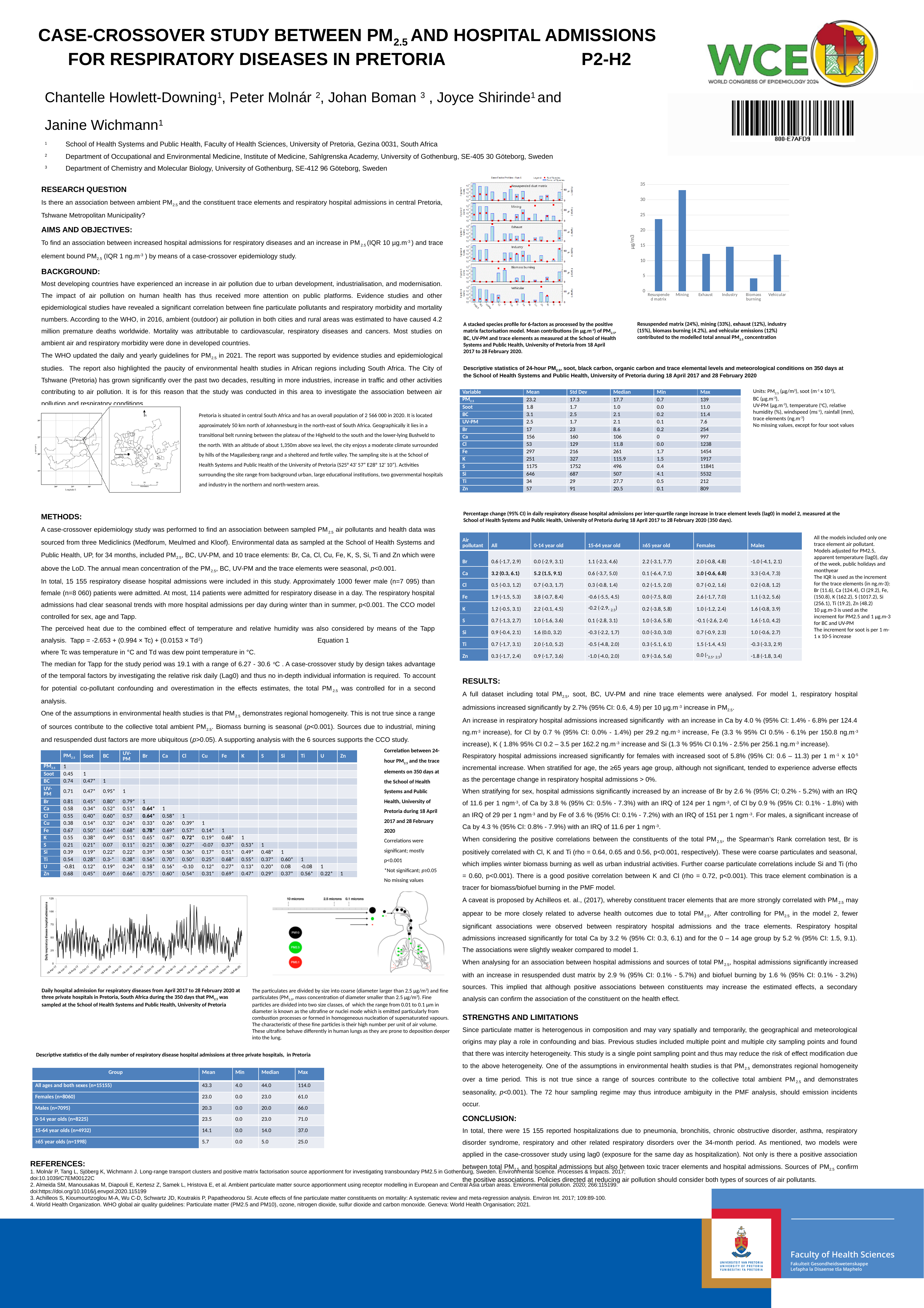
In the bar chart of source contributions (µg/m3) at the top right, is the value for Resuspended matrix greater or less than 20? greater In the bar chart of source contributions (µg/m3) at the top right, which source has the highest bar? Mining What kind of chart is the chart at the top right showing source contributions in µg/m3? bar chart In the bar chart of source contributions (µg/m3) at the top right, is the value for Exhaust greater or less than 15? less What kind of chart is the chart at the bottom left showing daily respiratory disease hospital admissions over time? line chart In the bar chart of source contributions (µg/m3) at the top right, is the value for Mining greater or less than 30? greater In the bar chart of source contributions (µg/m3) at the top right, which is larger, the bar for Industry or the bar for Biomass burning? Industry What is the y-axis label of the bar chart of source contributions at the top right? µg/m3 In the bar chart of source contributions (µg/m3) at the top right, which is larger, the bar for Mining or the bar for Resuspended matrix? Mining In the bar chart of source contributions (µg/m3) at the top right, how many source categories are shown on the x axis? 6 In the bar chart of source contributions (µg/m3) at the top right, which source has the lowest bar? Biomass burning